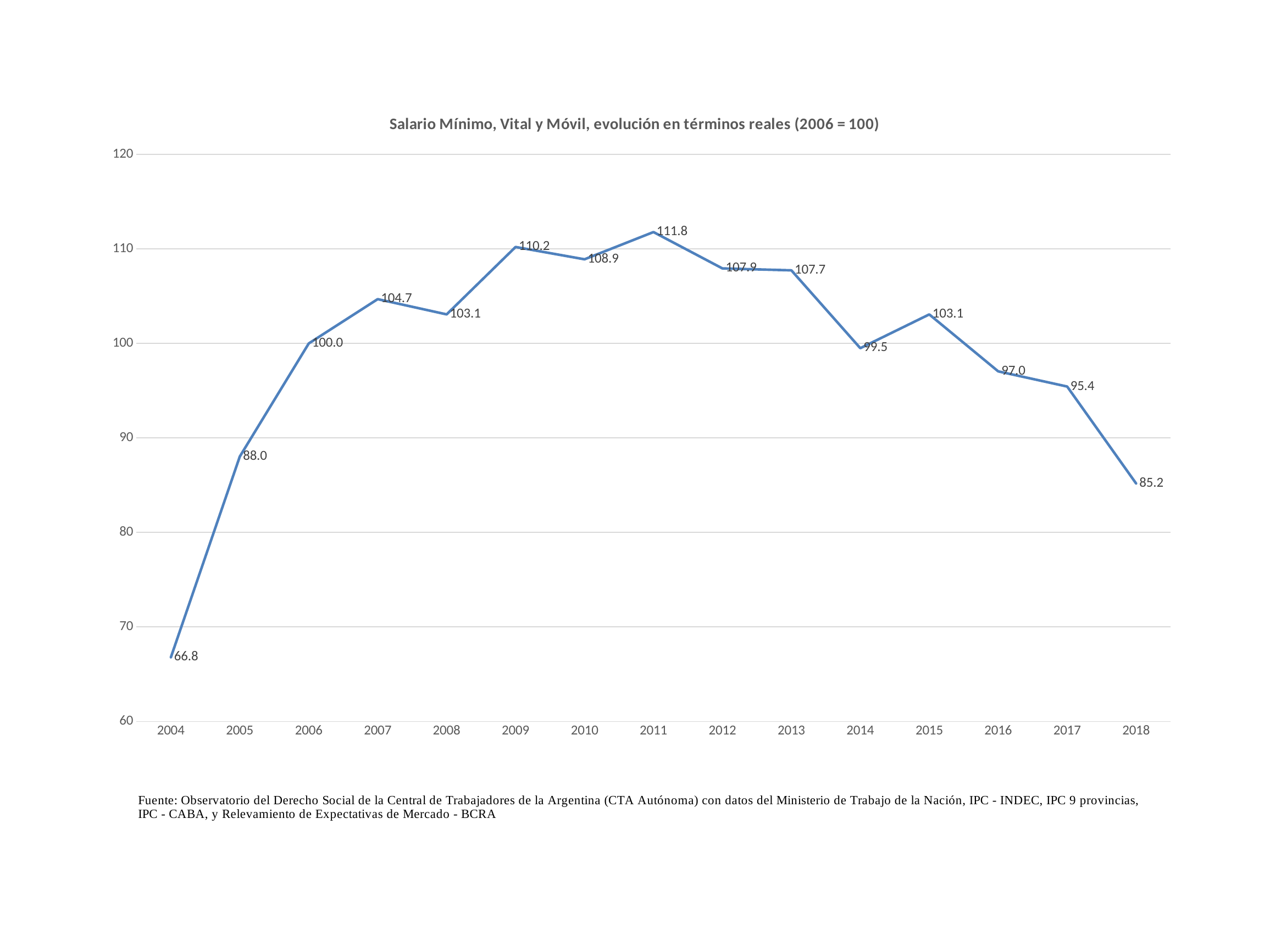
Which is larger, the value for 2009 or the value for 2010? 2009 What is the title of the chart? Salario Mínimo, Vital y Móvil, evolución en términos reales (2006 = 100) What is the value for 2018? 85.2 Do the values rise or fall from 2013 to 2018? fall What is the value for 2004? 66.8 Which year has the lowest value? 2004 What is the difference between the values for 2011 and 2018? 26.6 How many years are plotted on the x axis? 15 What is the value for 2011? 111.8 What kind of chart is shown? line chart Which year has the highest value? 2011 Is the value for 2014 greater or less than 100? less